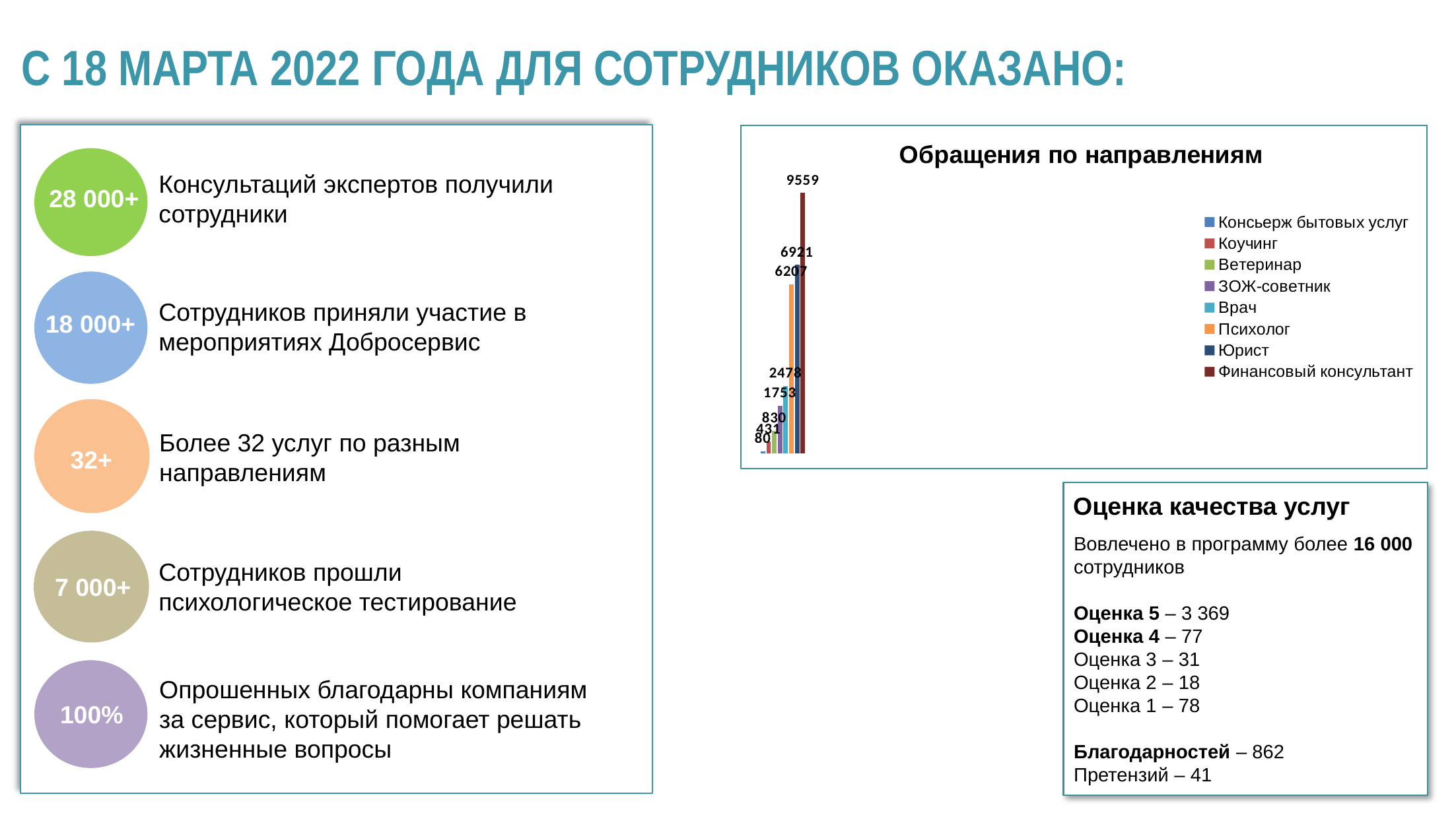
What is the title of the chart on the slide? Обращения по направлениям In "Обращения по направлениям", what is the value for Финансовый консультант? 9559 In "Обращения по направлениям", which series has the lowest value? Консьерж бытовых услуг In "Обращения по направлениям", what is the value for Врач? 2478 In "Обращения по направлениям", what is the value for Юрист? 6921 In "Обращения по направлениям", what is the value for Психолог? 6207 What type of chart is "Обращения по направлениям"? bar chart In "Обращения по направлениям", what is the difference between Финансовый консультант and Юрист? 2638 In "Обращения по направлениям", which series has the highest value? Финансовый консультант In "Обращения по направлениям", what is the value for ЗОЖ-советник? 1753 In "Обращения по направлениям", which is larger: Психолог or Врач? Психолог How many series does the legend of "Обращения по направлениям" list? 8